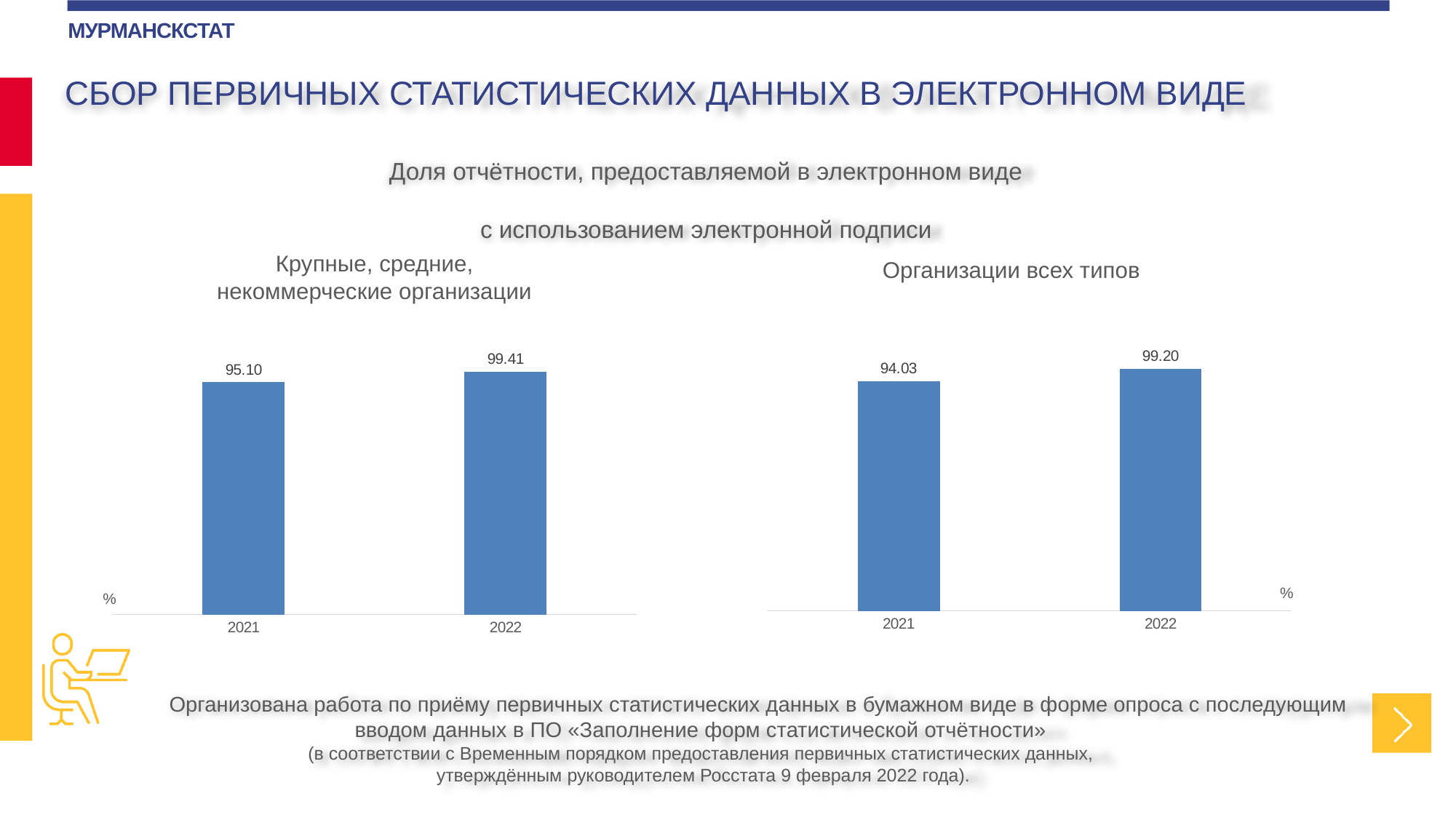
In the left chart (Крупные, средние, некоммерческие организации), by how much did the value increase from 2021 to 2022? 4.31 In the right chart (Организации всех типов), what is the value for 2021? 94.03 In the right chart (Организации всех типов), do the values rise or fall from 2021 to 2022? rise In the left chart (Крупные, средние, некоммерческие организации), what is the value for 2022? 99.41 In the right chart (Организации всех типов), what is the value for 2022? 99.20 In the right chart (Организации всех типов), which year has the lower value? 2021 In the left chart (Крупные, средние, некоммерческие организации), which year has the higher value? 2022 How many bars are shown in the left chart (Крупные, средние, некоммерческие организации)? 2 Which is larger: the 2021 value in the left chart (Крупные, средние, некоммерческие организации) or the 2021 value in the right chart (Организации всех типов)? Left chart (95.10) What type of chart is used on this slide? bar chart In the right chart (Организации всех типов), what is the difference between the 2022 and 2021 values? 5.17 In the left chart (Крупные, средние, некоммерческие организации), what is the value for 2021? 95.10